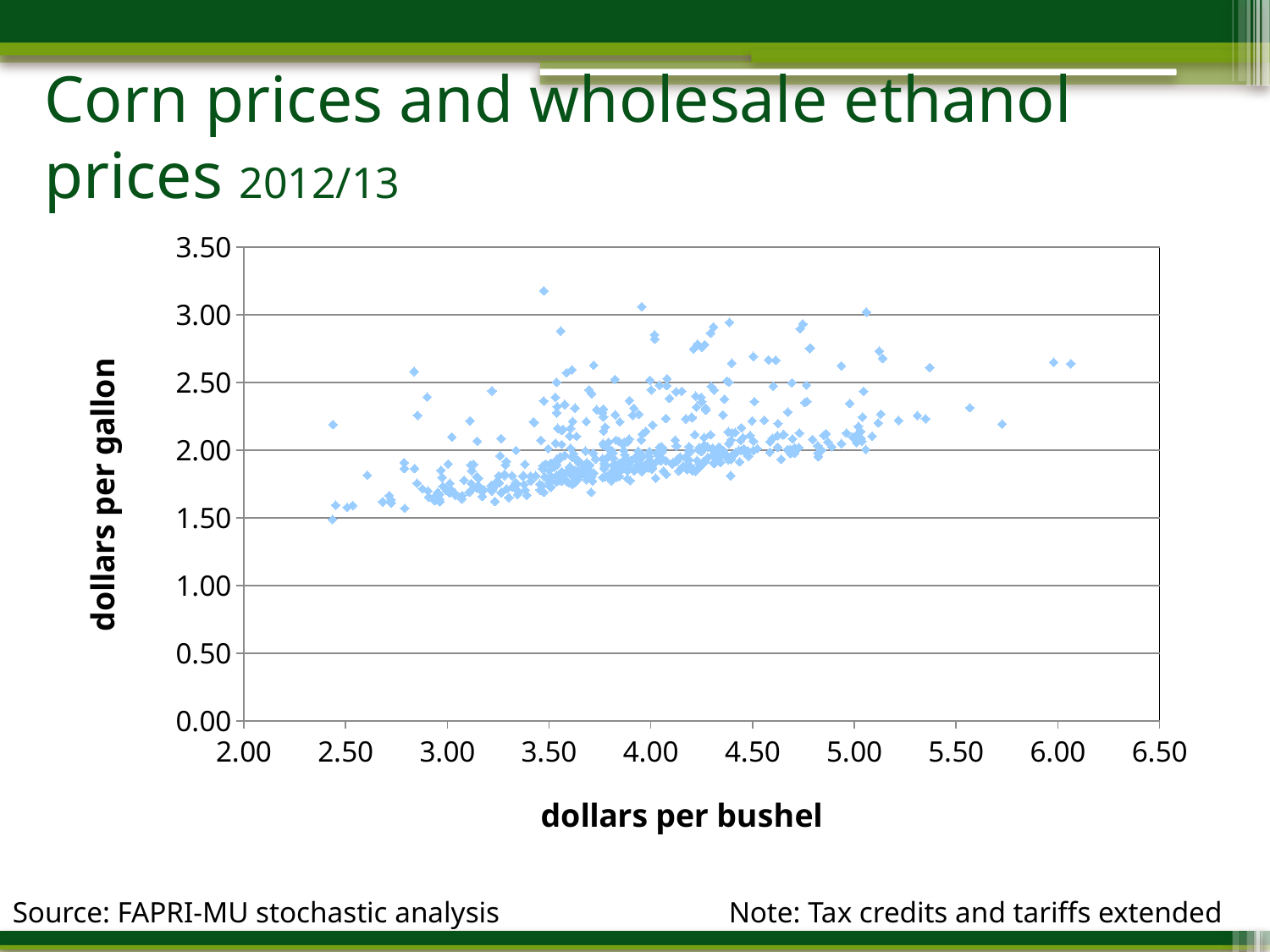
What is the label on the x axis of the chart? dollars per bushel As corn prices (dollars per bushel) increase along the x axis, do the ethanol prices generally rise or fall? rise Is the highest ethanol price plotted on the chart greater or less than 3.00 dollars per gallon? greater What kind of chart is shown on the slide? scatter chart What is the label on the y axis of the chart? dollars per gallon Is the highest corn price plotted on the chart greater or less than 6.00 dollars per bushel? greater Is the lowest corn price plotted on the chart greater or less than 2.50 dollars per bushel? less